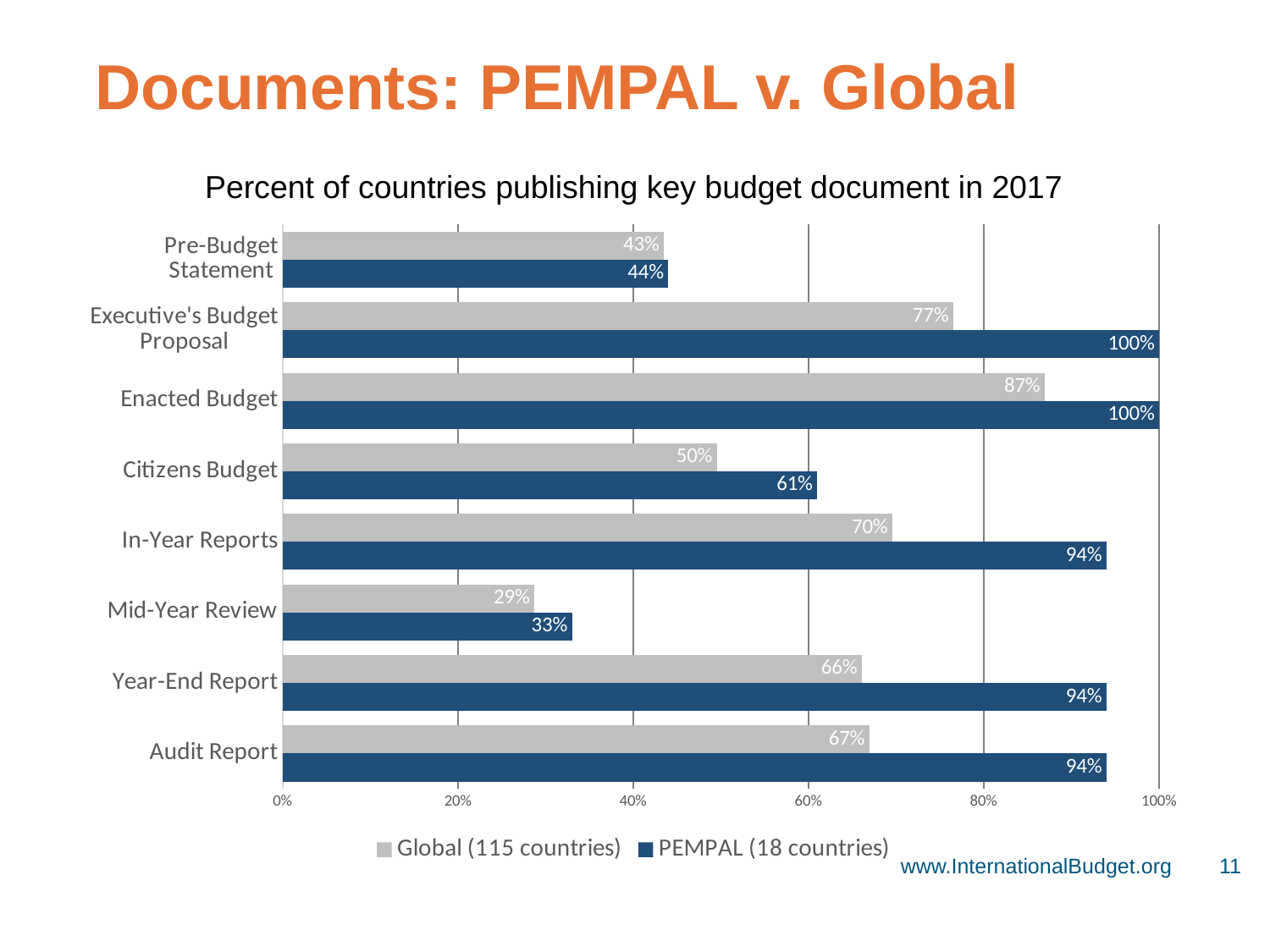
What is the PEMPAL value for Citizens Budget? 61% What is the difference between the PEMPAL and Global values for Executive's Budget Proposal? 23 percentage points What is the Global value for Mid-Year Review? 29% Which document has the lowest PEMPAL value? Mid-Year Review What kind of chart is shown on the slide? Bar chart Which document has the highest Global value? Enacted Budget How many series does the legend list? 2 What percentage of Global countries published a Pre-Budget Statement? 43% Which is larger for In-Year Reports: the Global value or the PEMPAL value? PEMPAL How many budget document categories are shown on the chart? 8 What is the chart's title? Percent of countries publishing key budget document in 2017 How many countries are in the PEMPAL group according to the legend? 18 countries